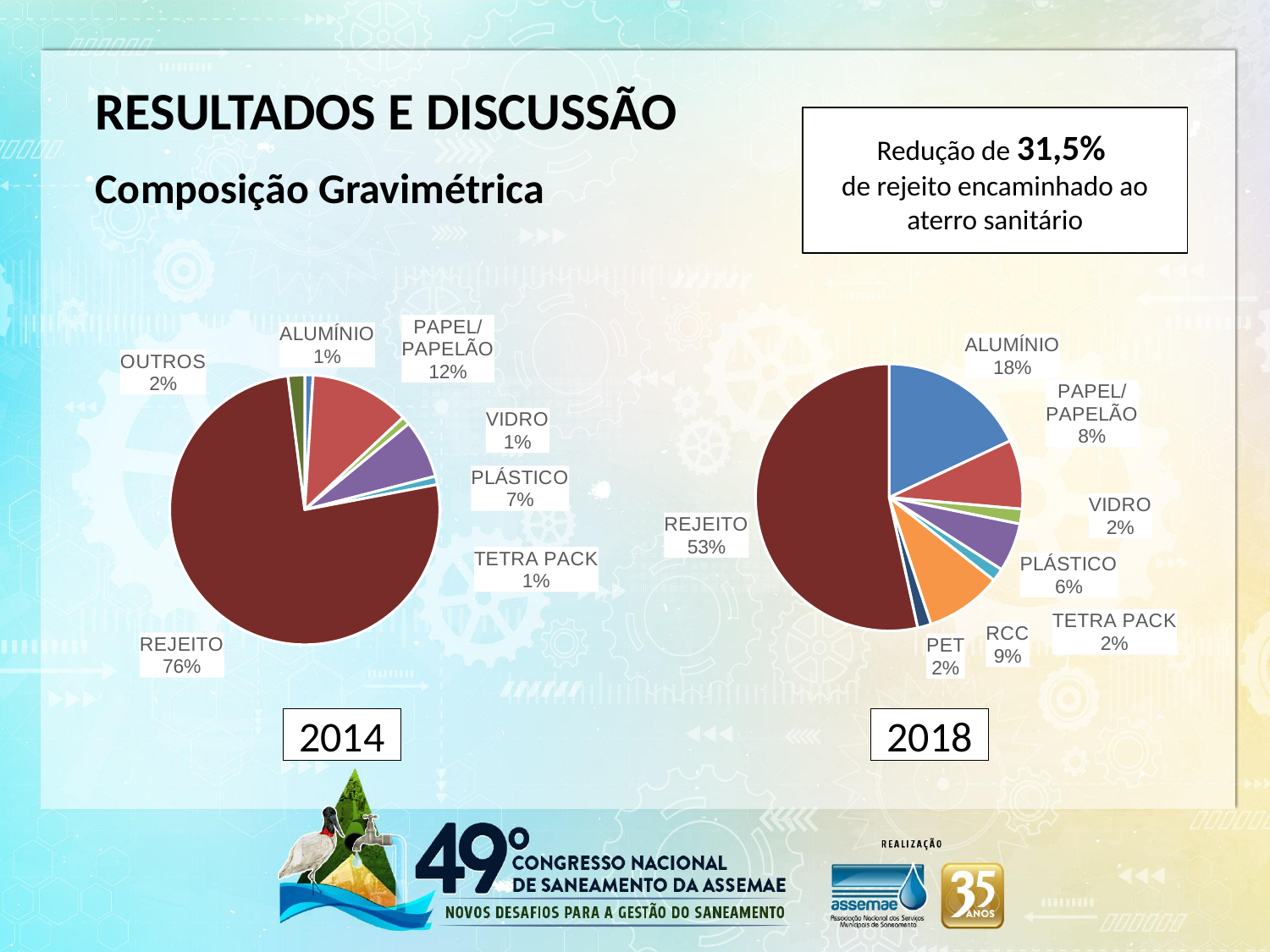
How many categories are shown in the 2018 pie chart? 8 In the 2018 pie chart, what share does RCC have? 9% How many categories are shown in the 2014 pie chart? 7 In the 2018 pie chart, which is larger: the share of PLÁSTICO or the share of PAPEL/PAPELÃO? PAPEL/PAPELÃO In the 2018 pie chart, what share does ALUMÍNIO have? 18% In the 2018 pie chart, what is the combined share of PET and TETRA PACK? 4% What is the difference between the REJEITO share in the 2014 chart and the REJEITO share in the 2018 chart? 23 percentage points In the 2018 pie chart, which category has the largest share? REJEITO In the 2014 pie chart, which category has the largest share? REJEITO In the 2014 pie chart, what share does REJEITO have? 76% In the 2014 pie chart, what share does PAPEL/PAPELÃO have? 12% What type of chart is used for the 2014 and 2018 data? Pie chart